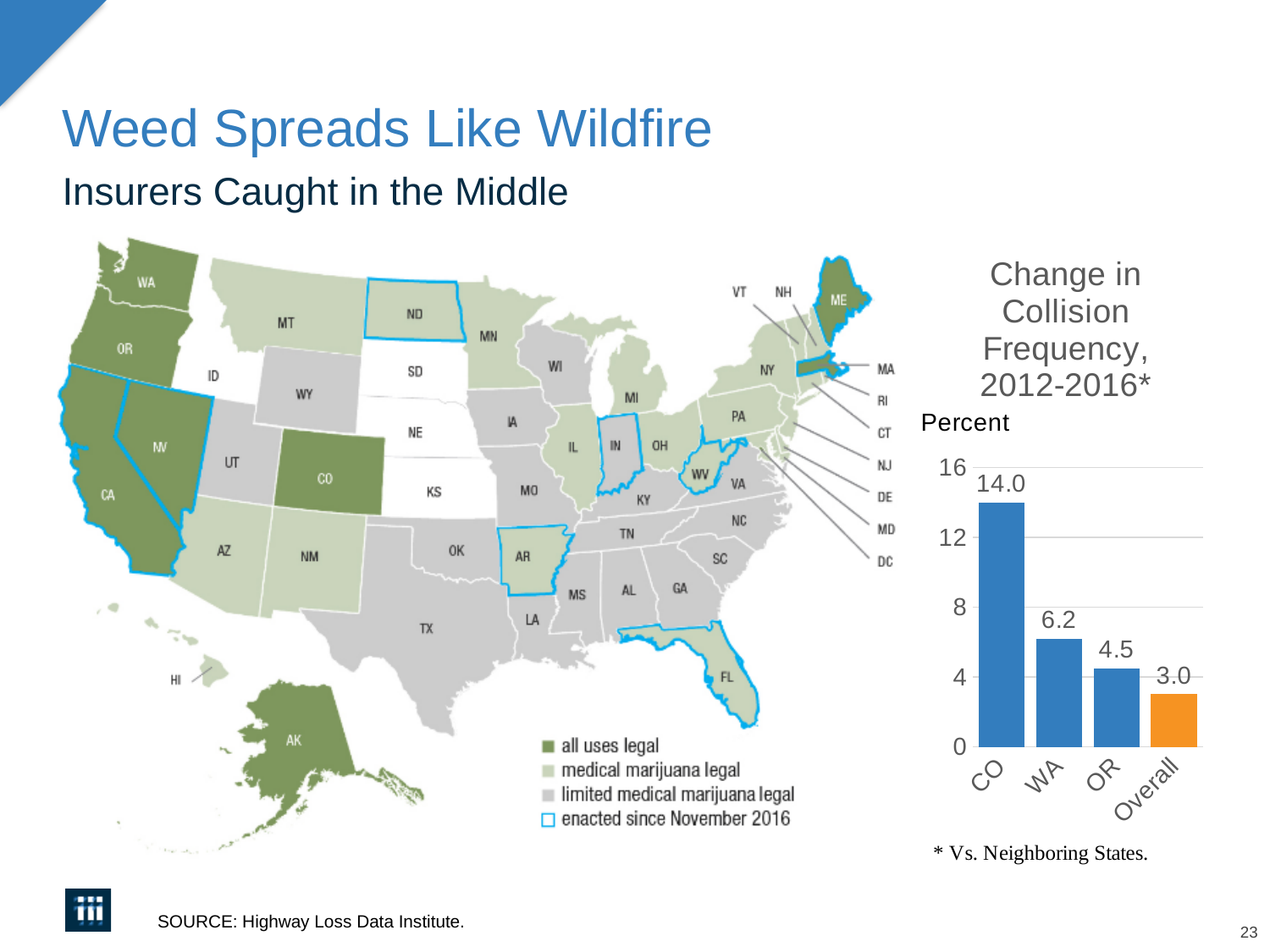
Which category has the lowest change in collision frequency? Overall What is the change in collision frequency for OR? 4.5 What kind of chart shows the change in collision frequency? Bar chart Which is larger, the value for WA or the value for OR? WA Which category has the highest change in collision frequency? CO What is the change in collision frequency for CO? 14.0 How many categories are shown in the bar chart? 4 What is the title of the bar chart? Change in Collision Frequency, 2012-2016* What is the Overall change in collision frequency? 3.0 What is the change in collision frequency for WA? 6.2 What is the difference between the values for CO and WA? 7.8 What is the difference between the values for OR and Overall? 1.5